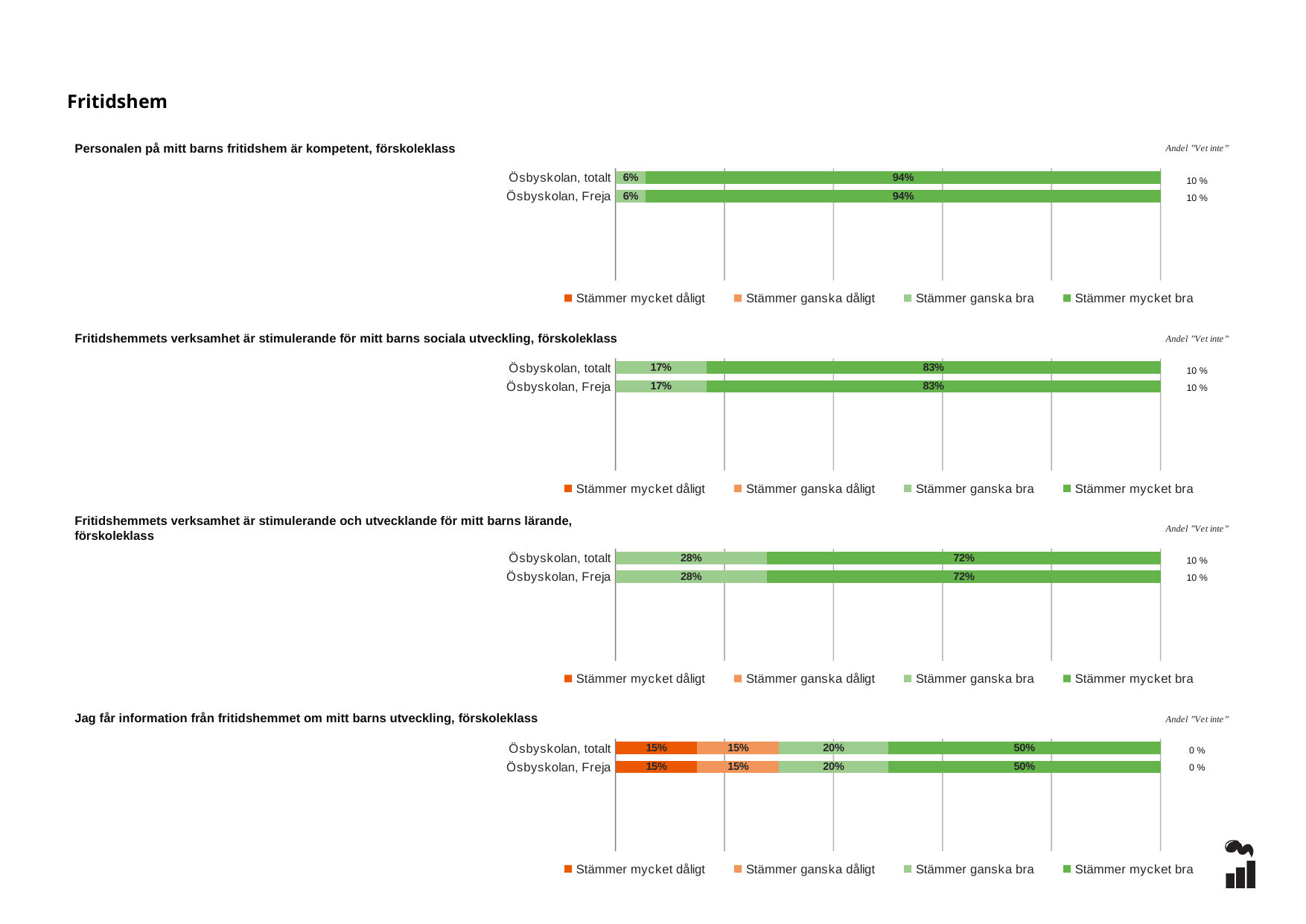
In the chart 'Fritidshemmets verksamhet är stimulerande och utvecklande för mitt barns lärande, förskoleklass', which is larger for Ösbyskolan, Freja: 'Stämmer ganska bra' or 'Stämmer mycket bra'? Stämmer mycket bra In the chart 'Jag får information från fritidshemmet om mitt barns utveckling, förskoleklass', which response category has the highest value for Ösbyskolan, totalt? Stämmer mycket bra What kind of chart is 'Jag får information från fritidshemmet om mitt barns utveckling, förskoleklass'? Stacked bar chart How many series does the legend list in the chart 'Personalen på mitt barns fritidshem är kompetent, förskoleklass'? 4 In the chart 'Jag får information från fritidshemmet om mitt barns utveckling, förskoleklass', what is the total of the stacked bar for Ösbyskolan, Freja? 100% In the chart 'Fritidshemmets verksamhet är stimulerande och utvecklande för mitt barns lärande, förskoleklass', what is the value of 'Stämmer ganska bra' for Ösbyskolan, totalt? 28% In the chart 'Jag får information från fritidshemmet om mitt barns utveckling, förskoleklass', what is the value of 'Stämmer mycket dåligt' for Ösbyskolan, totalt? 15% In the chart 'Fritidshemmets verksamhet är stimulerande för mitt barns sociala utveckling, förskoleklass', what is the value of 'Stämmer mycket bra' for Ösbyskolan, totalt? 83% In the chart 'Jag får information från fritidshemmet om mitt barns utveckling, förskoleklass', what is the value of 'Stämmer ganska bra' for Ösbyskolan, Freja? 20% In the chart 'Personalen på mitt barns fritidshem är kompetent, förskoleklass', what is the value of 'Stämmer mycket bra' for Ösbyskolan, totalt? 94% In the chart 'Personalen på mitt barns fritidshem är kompetent, förskoleklass', what is the value of 'Stämmer ganska bra' for Ösbyskolan, Freja? 6% In the chart 'Fritidshemmets verksamhet är stimulerande för mitt barns sociala utveckling, förskoleklass', what is the difference between 'Stämmer mycket bra' and 'Stämmer ganska bra' for Ösbyskolan, Freja? 66%